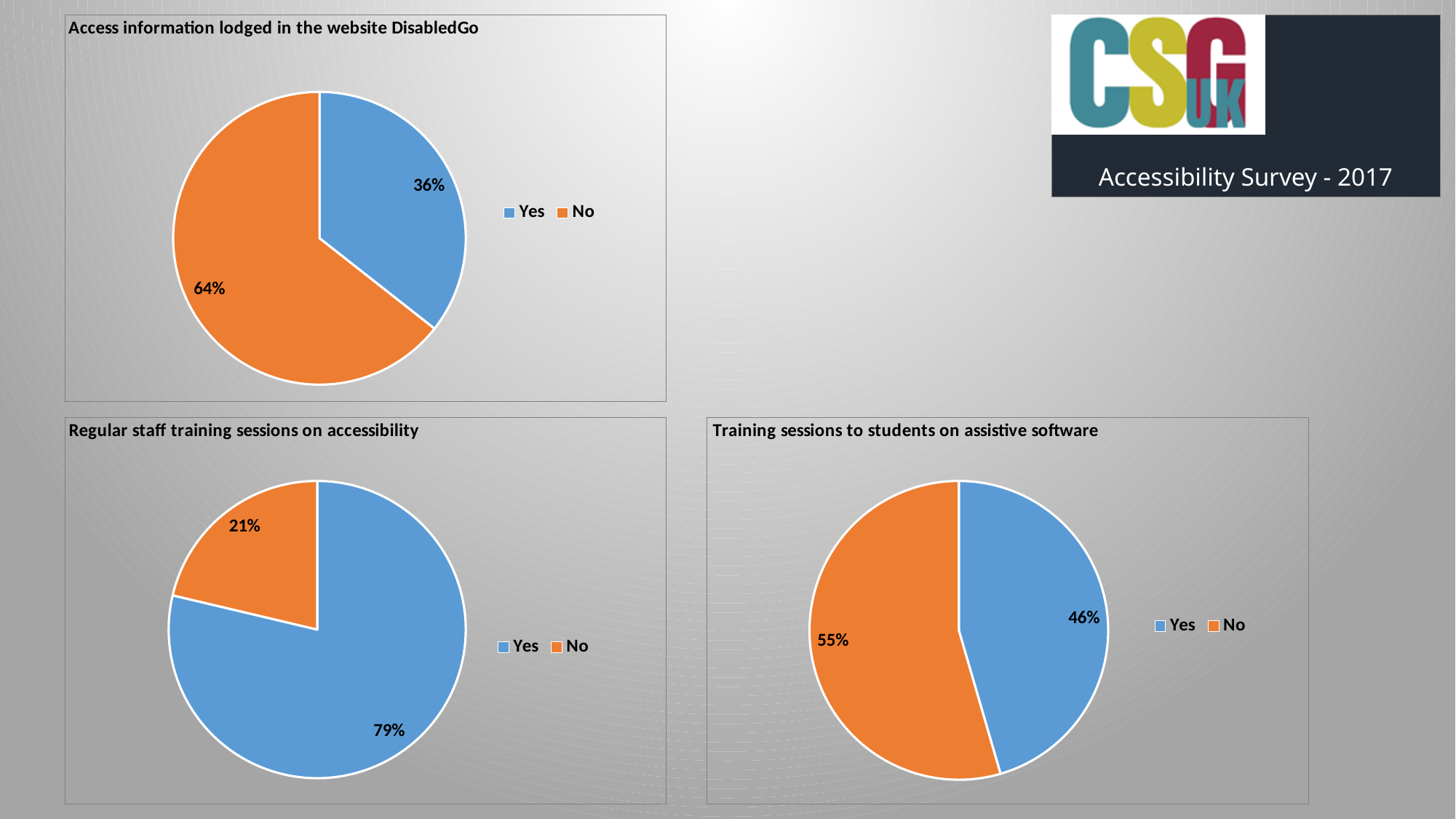
In the chart titled 'Access information lodged in the website DisabledGo', which response has the smaller share? Yes What type of chart is used in the chart titled 'Access information lodged in the website DisabledGo'? Pie chart In the chart titled 'Access information lodged in the website DisabledGo', what percentage answered Yes? 36% In the chart titled 'Training sessions to students on assistive software', what percentage answered Yes? 46% How many entries does the legend list in the chart titled 'Training sessions to students on assistive software'? 2 In the chart titled 'Training sessions to students on assistive software', what percentage answered No? 55% In the chart titled 'Regular staff training sessions on accessibility', what percentage answered Yes? 79% In the chart titled 'Regular staff training sessions on accessibility', what is the difference in percentage points between Yes and No? 58 In the chart titled 'Access information lodged in the website DisabledGo', what percentage answered No? 64% In the chart titled 'Regular staff training sessions on accessibility', which response has the larger share? Yes In the chart titled 'Training sessions to students on assistive software', is the share for Yes or No larger? No In the chart titled 'Regular staff training sessions on accessibility', what percentage answered No? 21%